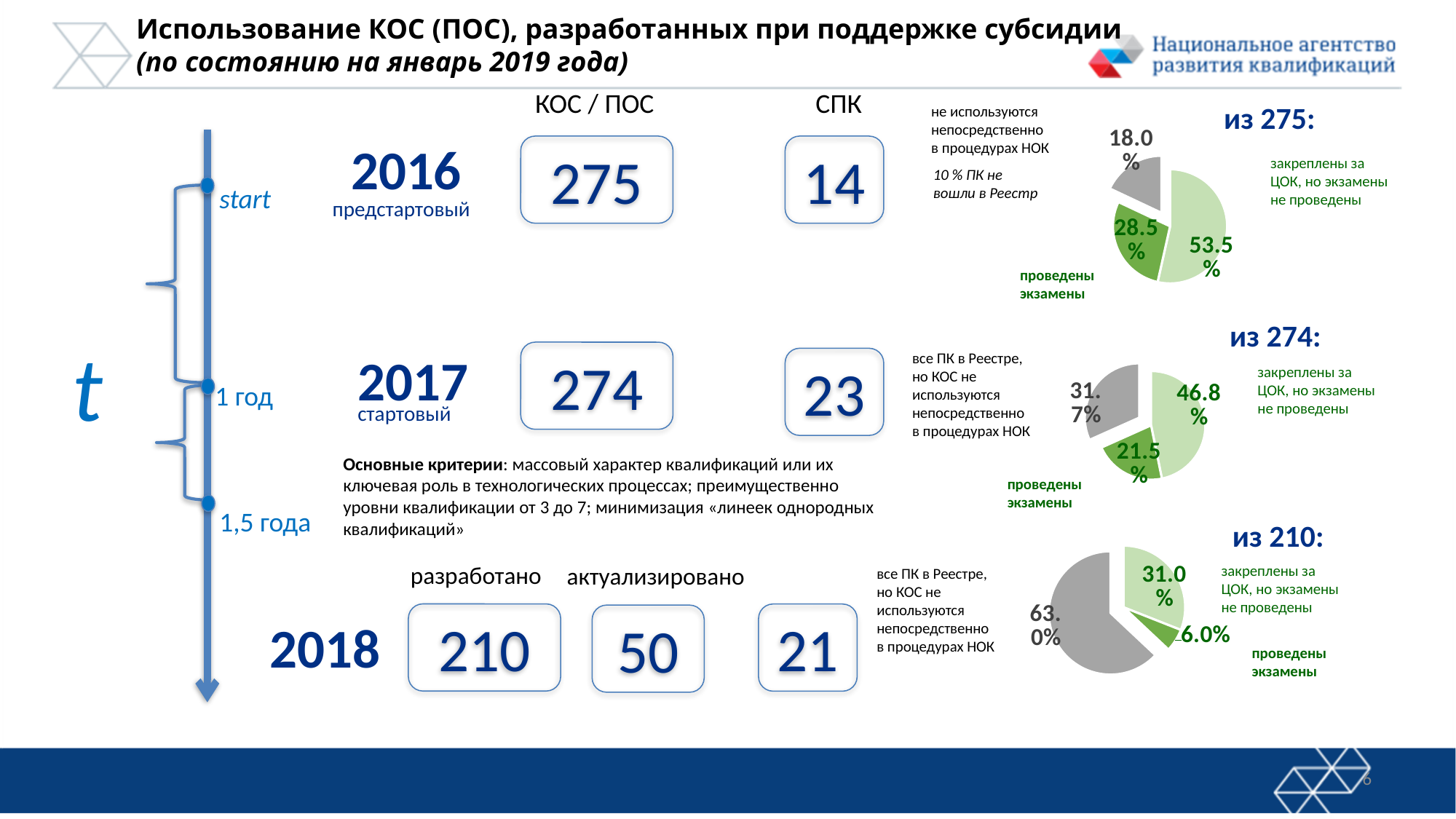
How many pie charts are shown on the slide? 3 In the pie chart titled "из 210:", what is the difference between the grey slice (63.0%) and the "закреплены за ЦОК, но экзамены не проведены" slice (31.0%)? 32.0% In the pie chart titled "из 275:", what share is labelled "закреплены за ЦОК, но экзамены не проведены"? 53.5% Which is larger: the "проведены экзамены" share in the "из 275:" chart or in the "из 274:" chart? из 275: In the pie chart titled "из 275:", what share is labelled "проведены экзамены"? 28.5% In the pie chart titled "из 210:", what is the share of the grey slice? 63.0% In the pie chart titled "из 275:", what is the share of the grey slice (не используются непосредственно в процедурах НОК)? 18.0% In the pie chart titled "из 274:", which category has the largest share? закреплены за ЦОК, но экзамены не проведены In the pie chart titled "из 210:", which category has the smallest share? проведены экзамены In the pie chart titled "из 274:", what share is labelled "проведены экзамены"? 21.5% What type of chart is used for the "из 275:", "из 274:" and "из 210:" breakdowns? pie chart How many slices does the pie chart titled "из 274:" have? 3